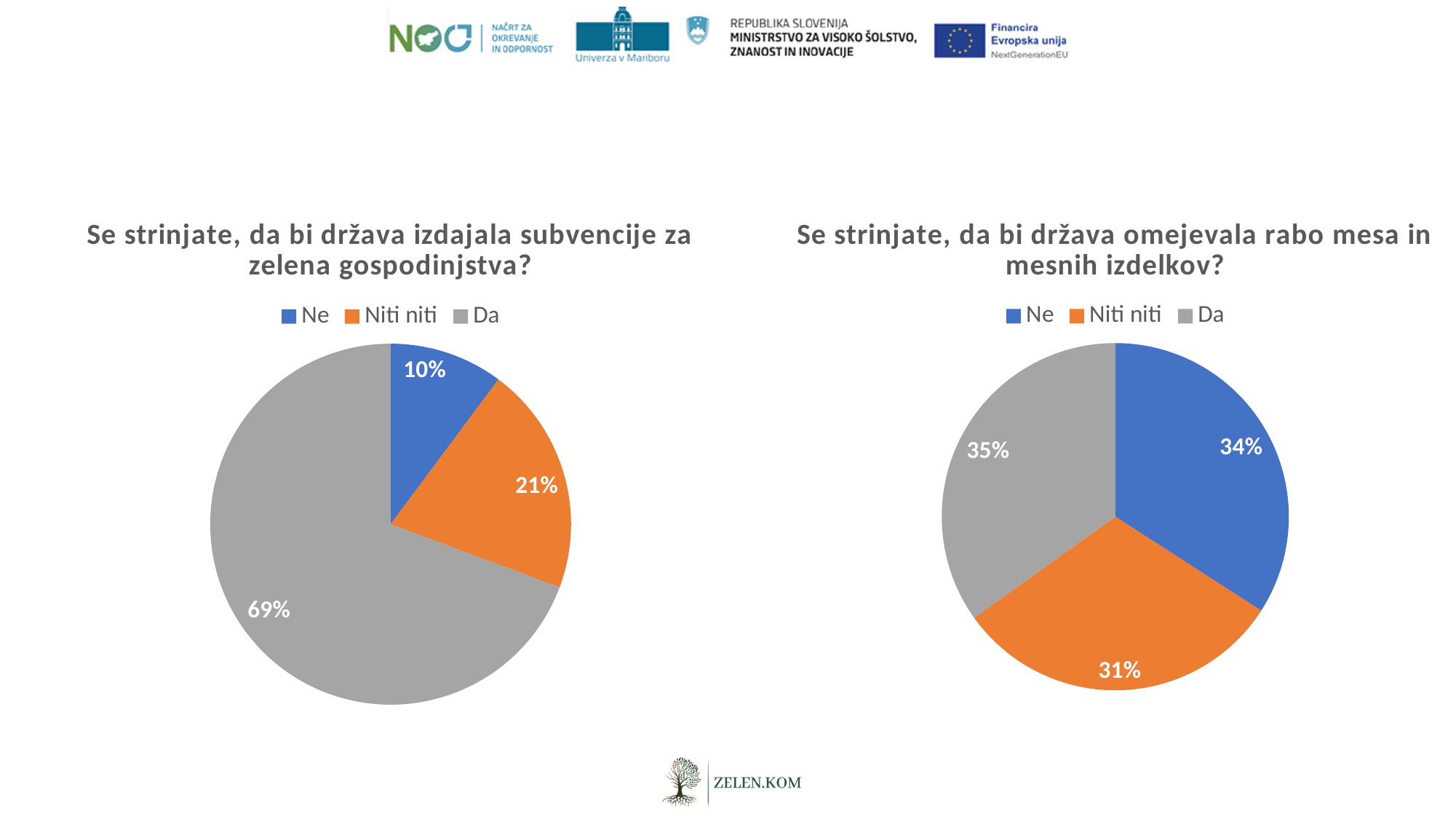
How many categories does each pie chart on the slide have? 3 In the right pie chart (limiting meat consumption), what share of respondents answered 'Da'? 35% In the left pie chart (subsidies for green households), what share of respondents answered 'Ne'? 10% In the left pie chart (subsidies for green households), which answer has the smallest share? Ne What type of chart is used on the slide? Pie chart In the left pie chart (subsidies for green households), what share of respondents answered 'Da'? 69% In the left pie chart (subsidies for green households), which answer has the largest share? Da In the right pie chart (limiting meat consumption), which answer has the smallest share? Niti niti Which is larger: the 'Ne' share in the left pie chart or the 'Ne' share in the right pie chart? The right pie chart (34%) In the right pie chart (limiting meat consumption), what share of respondents answered 'Niti niti'? 31% In the left pie chart (subsidies for green households), what is the difference in percentage points between 'Da' and 'Niti niti'? 48 In the right pie chart (limiting meat consumption), what is the difference in percentage points between 'Da' and 'Ne'? 1